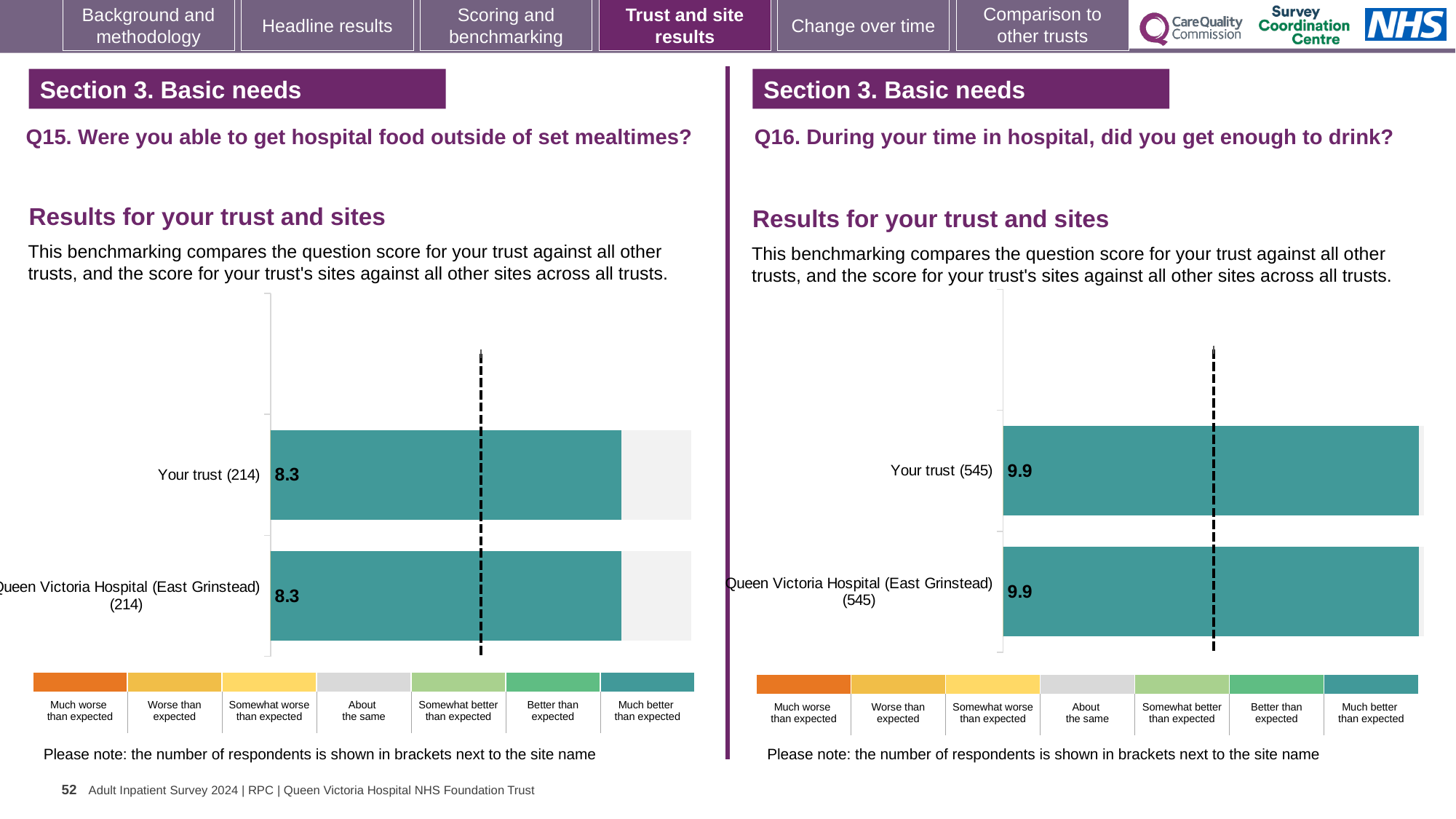
On the Q15 chart (left), what is the difference between the score for Your trust and the score for Queen Victoria Hospital (East Grinstead)? 0 On the Q15 chart (left), what is the score for Your trust? 8.3 On the Q16 chart (right), what is the score for Queen Victoria Hospital (East Grinstead)? 9.9 How many bars are plotted on the Q15 chart (left)? 2 On the Q15 chart (left), how many respondents are shown in brackets for Your trust? 214 On the Q16 chart (right), what is the score for Your trust? 9.9 How many bars are plotted on the Q16 chart (right)? 2 On the Q16 chart (right), how many respondents are shown in brackets for Queen Victoria Hospital (East Grinstead)? 545 On the Q15 chart (left), what is the score for Queen Victoria Hospital (East Grinstead)? 8.3 What kind of chart is the Q15 chart (left)? Bar chart Is the score for Your trust on the Q16 chart (right) larger or smaller than the score for Your trust on the Q15 chart (left)? Larger On the Q16 chart (right), what is the difference between the score for Your trust and the score for Queen Victoria Hospital (East Grinstead)? 0